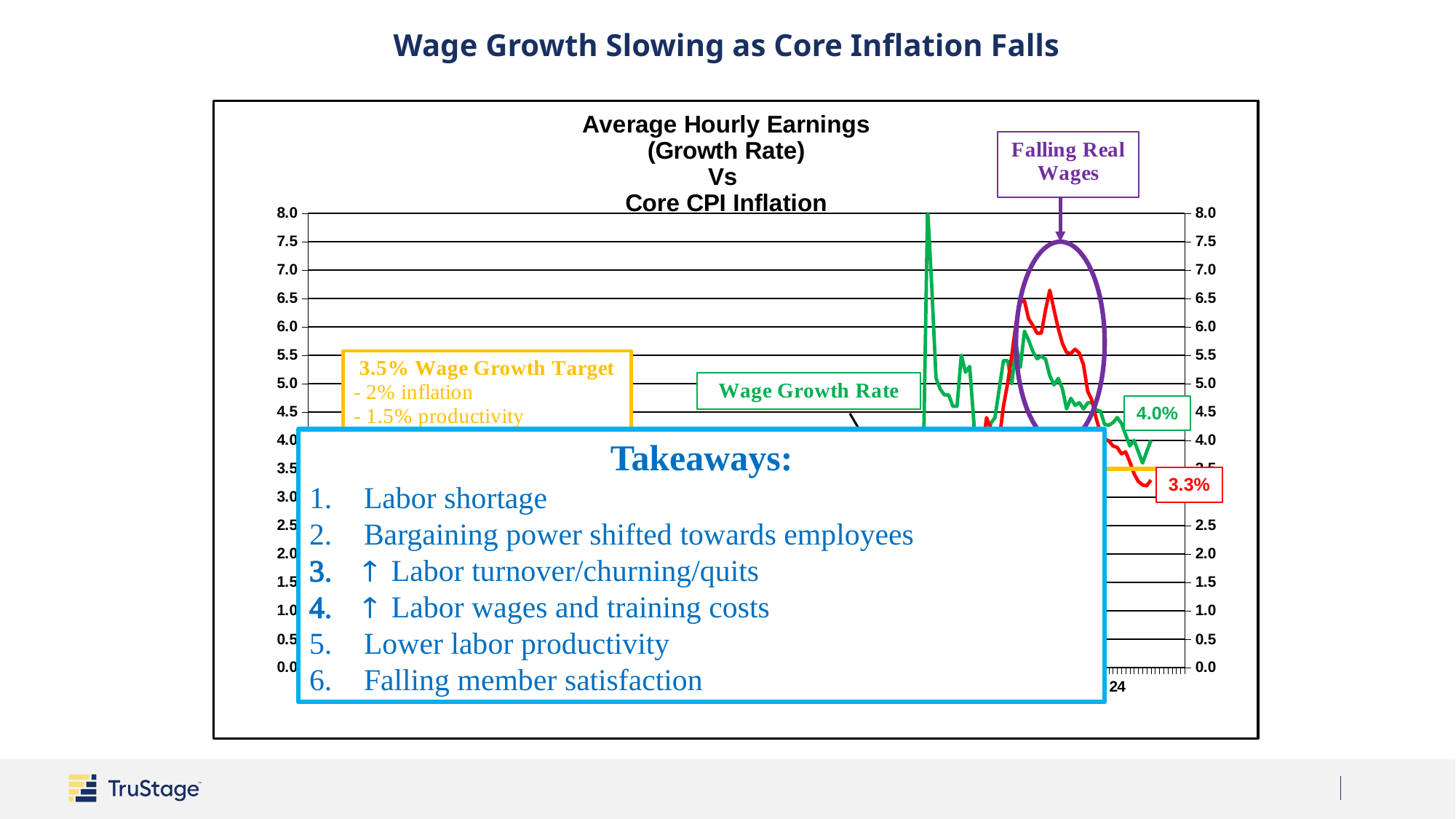
What is the latest labelled value of Core CPI Inflation (red line)? 3.3% What kind of chart is shown on the slide? line chart Is the peak of the Wage Growth Rate (green line) greater or less than 7.5? greater What is the latest labelled value of the Wage Growth Rate (green line)? 4.0% Is the peak of Core CPI Inflation (red line) greater or less than 6.0? greater Does the Wage Growth Rate rise or fall from its peak toward the right end of the chart? fall What is the title of the chart? Average Hourly Earnings (Growth Rate) Vs Core CPI Inflation Which is larger at the latest labelled point, the Wage Growth Rate or Core CPI Inflation? Wage Growth Rate What wage growth target is annotated on the chart? 3.5% What is the difference between the latest labelled Wage Growth Rate (4.0%) and Core CPI Inflation (3.3%)? 0.7 percentage points